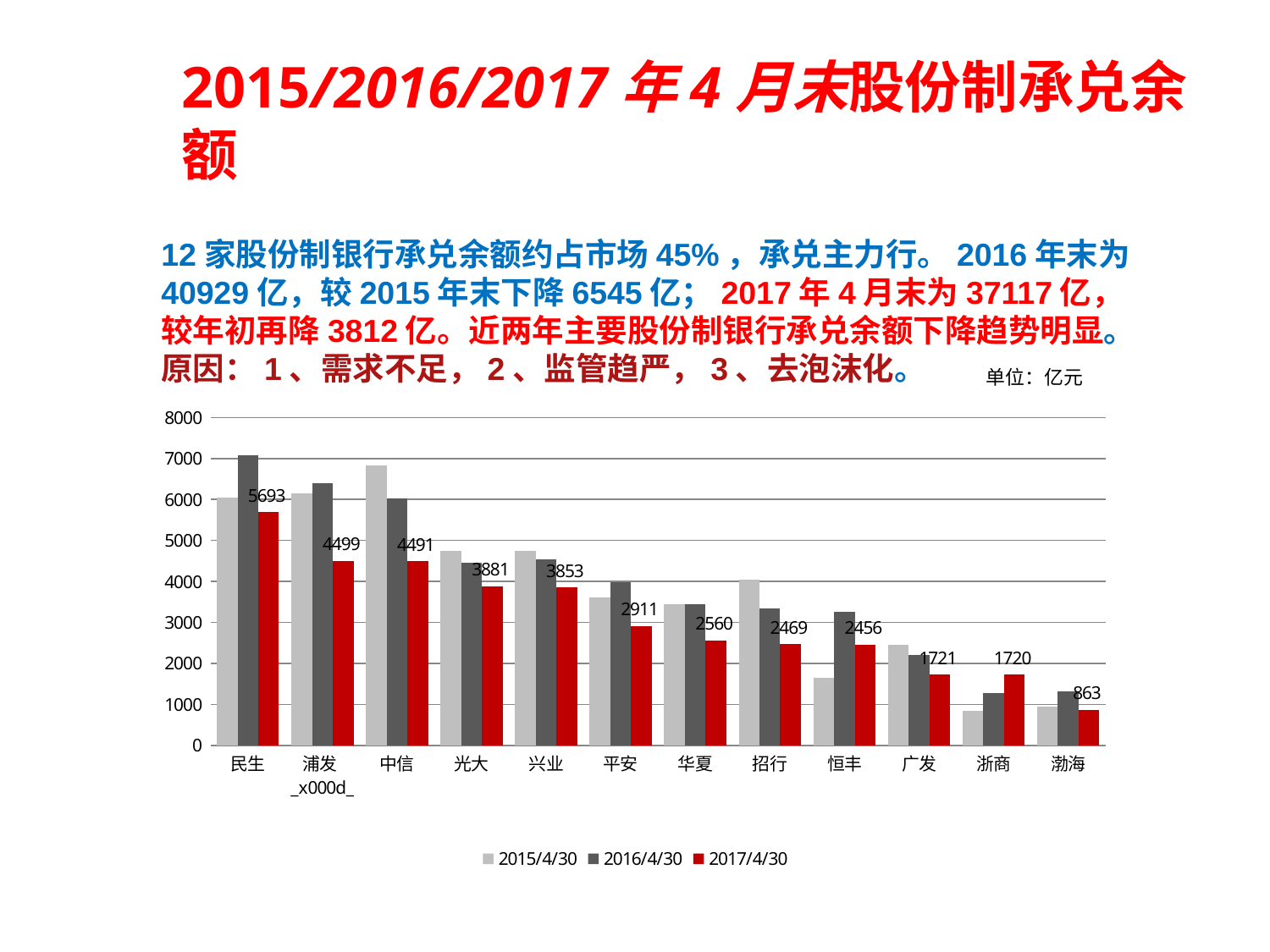
How many banks are shown on the x axis of the chart? 12 What is the value for 民生 in the 2017/4/30 series? 5693 For 恒丰, which is larger: the 2015/4/30 value or the 2016/4/30 value? 2016/4/30 What is the value for 平安 in the 2017/4/30 series? 2911 Is the 2015/4/30 value for 浙商 greater or less than 1000? less What is the difference between the 2017/4/30 values for 民生 and 浦发? 1194 What is the value for 渤海 in the 2017/4/30 series? 863 For 中信, which is larger: the 2015/4/30 value or the 2017/4/30 value? 2015/4/30 Which bank has the highest value in the 2017/4/30 series? 民生 How many series does the chart legend list? 3 Which bank has the lowest value in the 2017/4/30 series? 渤海 Is the 2015/4/30 value for 中信 greater or less than 6000? greater